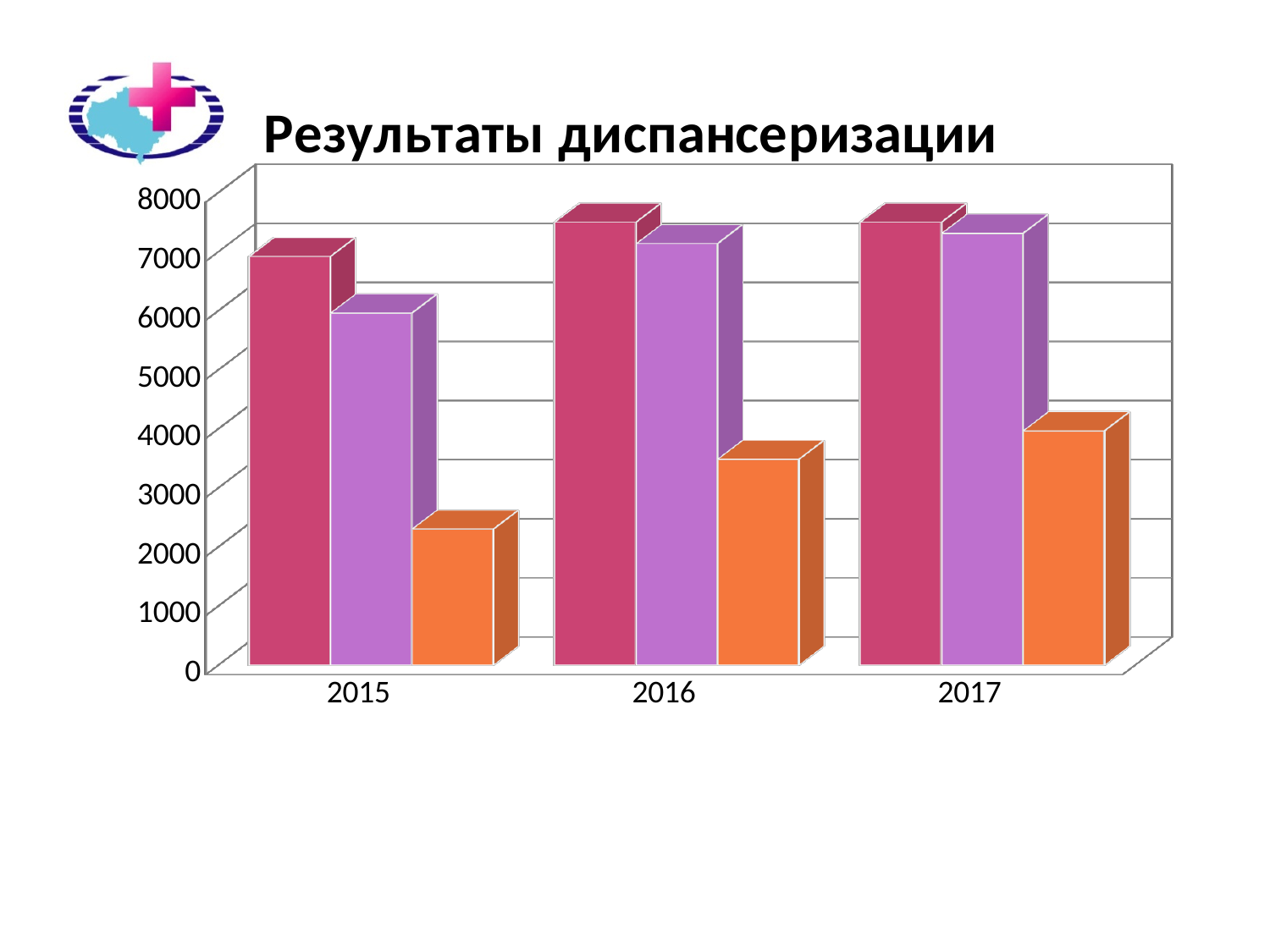
How many bars are plotted for each year in the chart? 3 Is the value of the orange bar for 2016 greater or less than 3000? greater How many years are shown on the x axis of the chart? 3 Which is larger, the purple bar for 2015 or the purple bar for 2016? 2016 In which year is the orange bar the lowest? 2015 Do the orange bars rise or fall from 2015 to 2017? rise Is the value of the orange bar for 2015 greater or less than 3000? less Is the value of the red bar for 2016 greater or less than 7000? greater In which year is the orange bar the highest? 2017 What is the title of the chart? Результаты диспансеризации What kind of chart is shown on the slide? bar chart